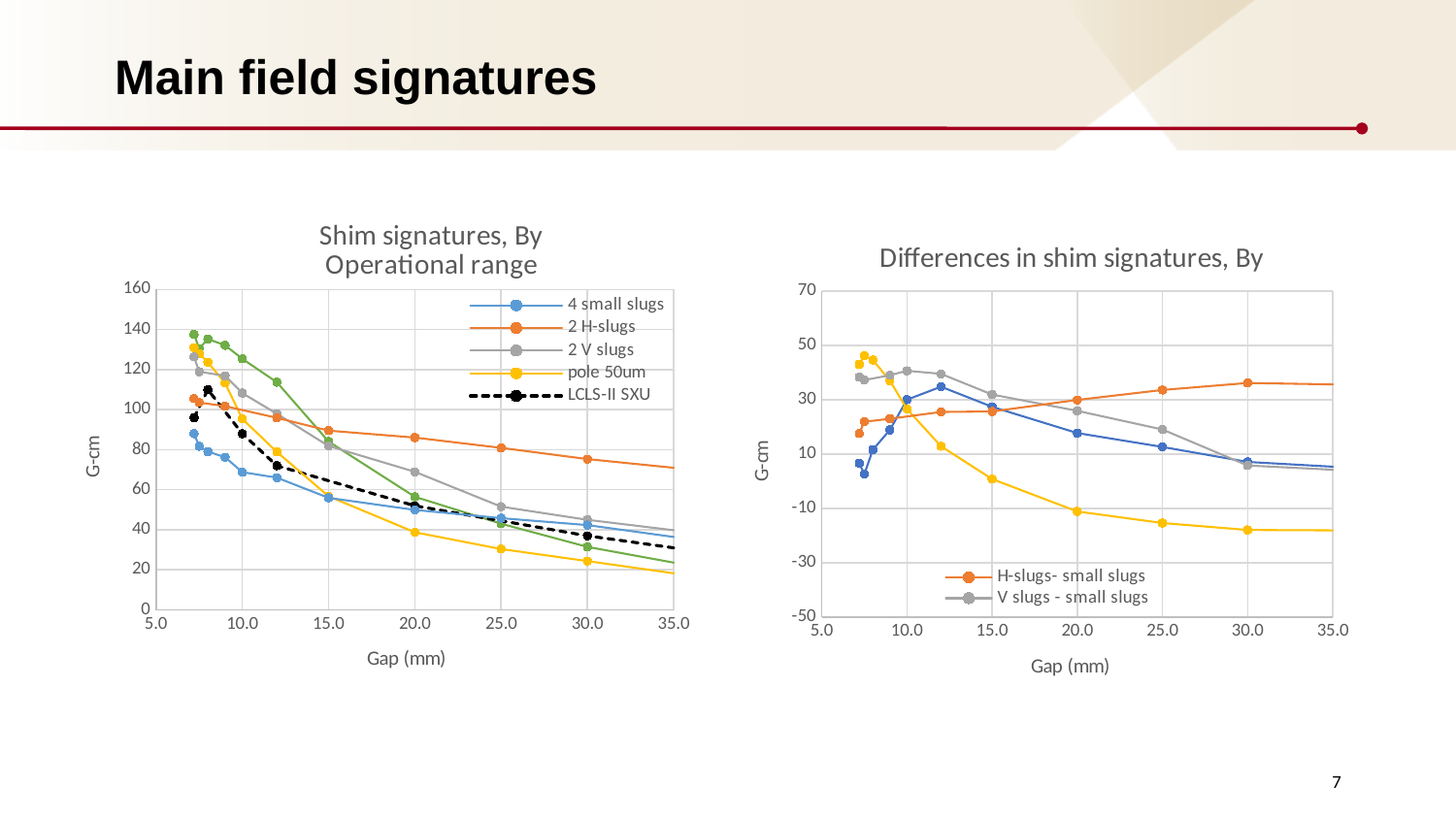
In the right chart "Differences in shim signatures, By", which is larger at a gap of 35.0: H-slugs- small slugs or V slugs - small slugs? H-slugs- small slugs In the left chart "Shim signatures, By Operational range", which series has the highest value at a gap of 35.0? 2 H-slugs In the left chart "Shim signatures, By Operational range", is the value for 2 H-slugs at a gap of 35.0 greater or less than 60? greater In the left chart "Shim signatures, By Operational range", is the value for pole 50um at a gap of 35.0 greater or less than 40? less How many series does the legend of the left chart "Shim signatures, By Operational range" list? 5 What kind of chart is the left chart titled "Shim signatures, By Operational range"? line chart In the left chart "Shim signatures, By Operational range", does the 2 H-slugs series rise or fall as the gap increases from 10.0 to 35.0? fall In the right chart "Differences in shim signatures, By", is the value for V slugs - small slugs at a gap of 35.0 greater or less than 10? less How many series does the legend of the right chart "Differences in shim signatures, By" list? 2 What is the x-axis label of the right chart "Differences in shim signatures, By"? Gap (mm) In the left chart "Shim signatures, By Operational range", which is larger at a gap of 10.0: 2 V slugs or 4 small slugs? 2 V slugs